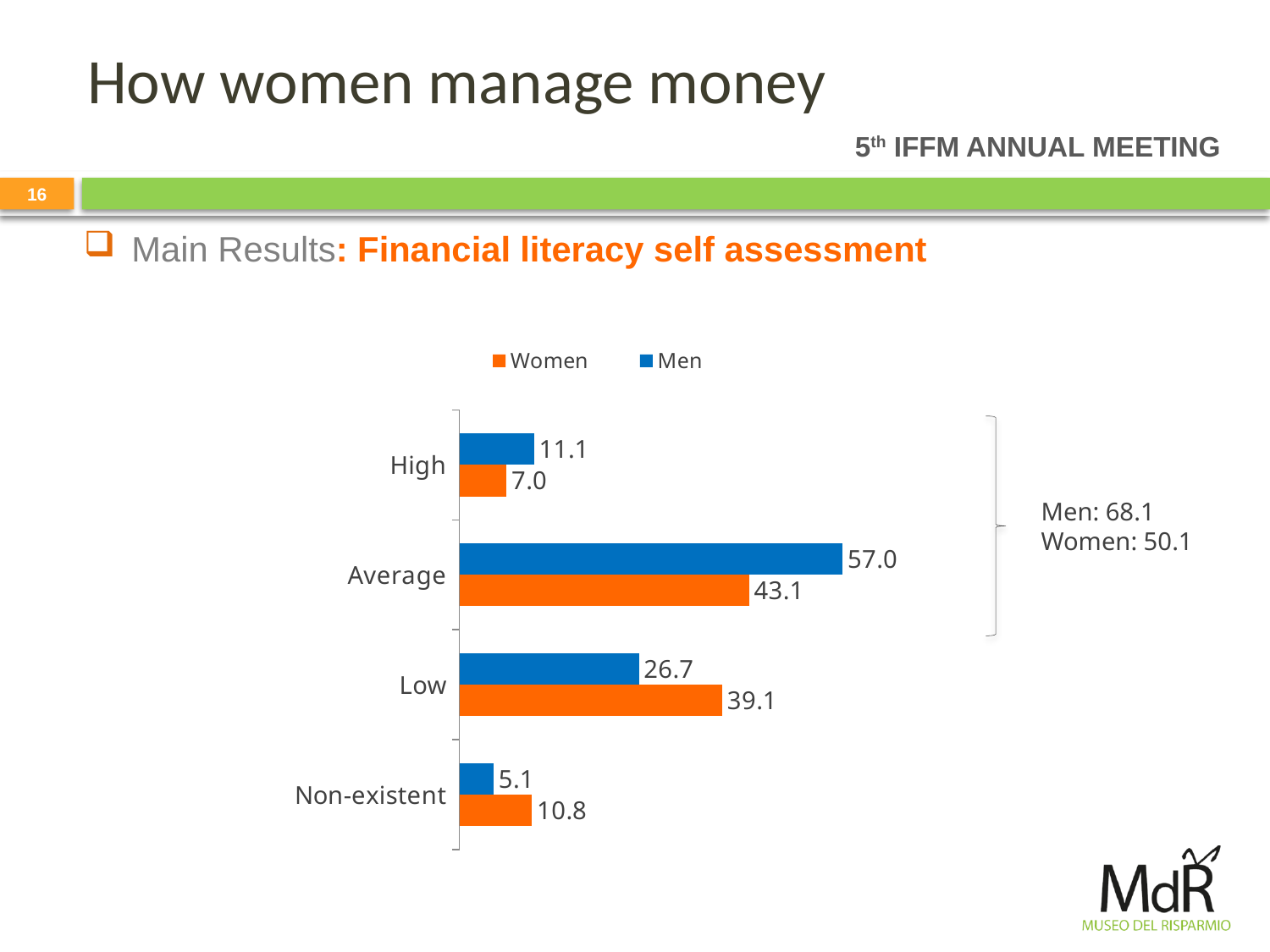
Which colour represents the Women series in the chart? Orange What is the value for Women in the Non-existent category? 10.8 How many series does the legend list? 2 What is the value for Men in the Low category? 26.7 Which category has the highest value for Men? Average What kind of chart is shown on the slide? Bar chart How many categories are shown on the chart? 4 What is the value for Women in the Average category? 43.1 Which category has the lowest value for Women? High What is the value for Men in the High category? 11.1 Which is larger in the Low category, the value for Women or the value for Men? Women What is the difference between the Men and Women values in the Average category? 13.9